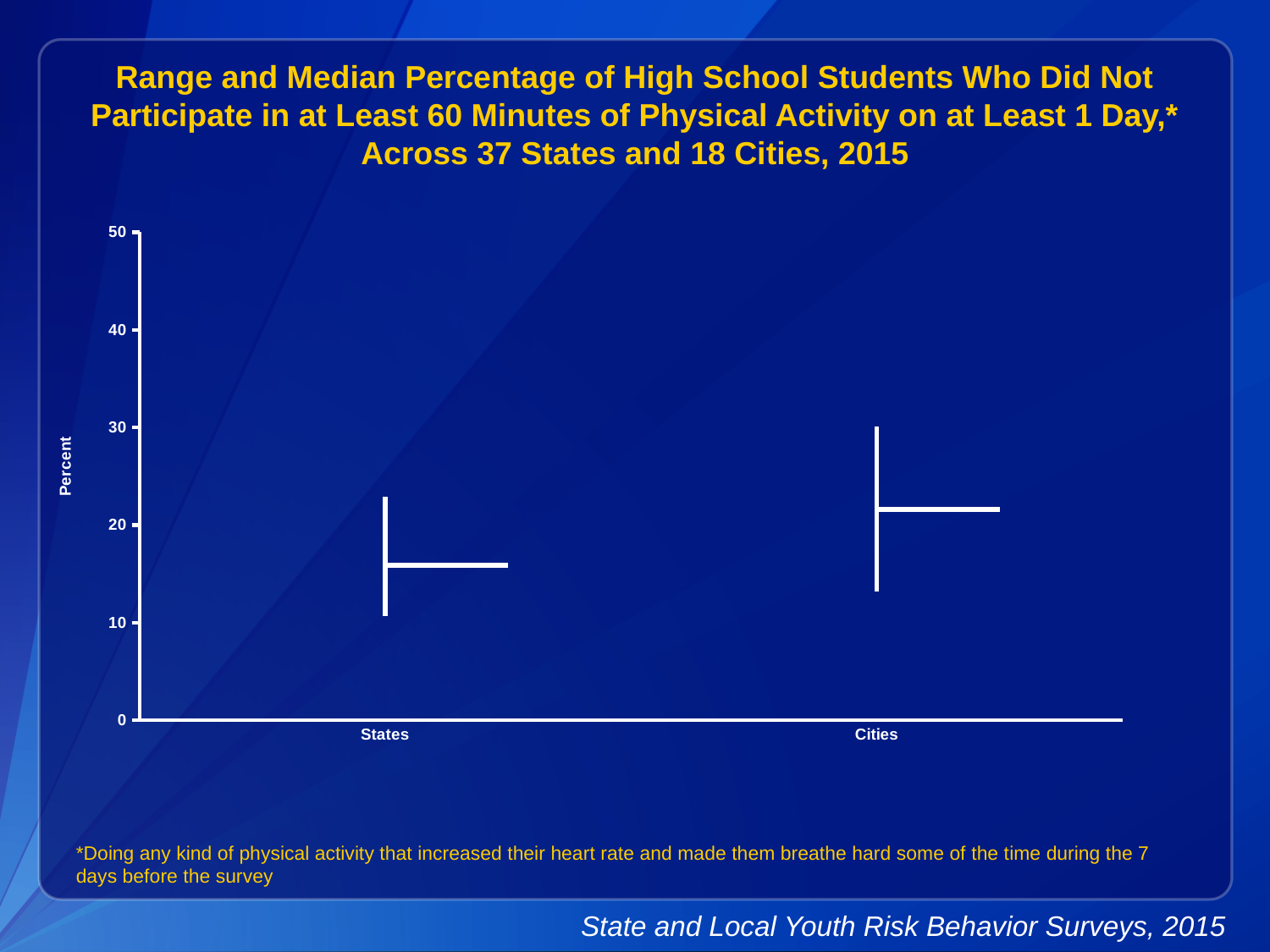
How many categories are shown on the x axis of the chart? 2 What is the highest value shown on the y axis? 50 Which category has the higher top of its range, States or Cities? Cities Is the top of the range for States greater or less than 30? less What are the two categories shown on the x axis? States and Cities Which category has the higher median percentage, States or Cities? Cities What is the label of the y axis? Percent Is the top of the range for Cities greater or less than 25? greater Is the bottom of the range for Cities greater or less than 20? less